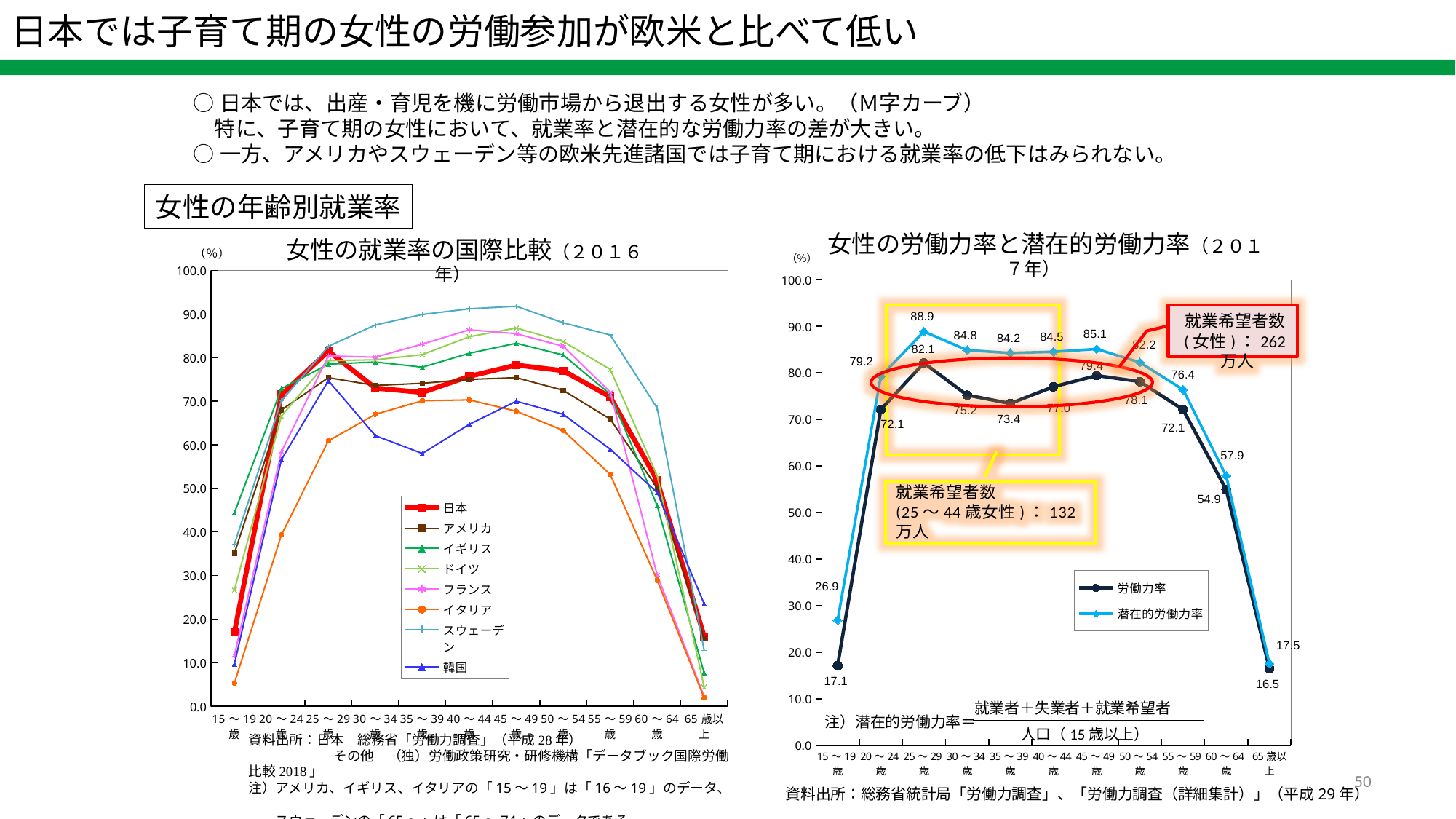
In the chart titled 女性の労働力率と潜在的労働力率（2017年）, how many series does the legend list? 2 In the chart titled 女性の就業率の国際比較（2016年）, is the value for 日本 at 35～39歳 greater or less than 80.0? less In the chart titled 女性の就業率の国際比較（2016年）, how many countries does the legend list? 8 In the chart titled 女性の就業率の国際比較（2016年）, is the value for イタリア at 15～19歳 greater or less than 10.0? less In the chart titled 女性の労働力率と潜在的労働力率（2017年）, which is larger for 60～64歳: 労働力率 or 潜在的労働力率? 潜在的労働力率 In the chart titled 女性の労働力率と潜在的労働力率（2017年）, what is the 労働力率 value for 35～39歳? 73.4 In the chart titled 女性の労働力率と潜在的労働力率（2017年）, which age group has the lowest 労働力率? 65歳以上 In the chart titled 女性の労働力率と潜在的労働力率（2017年）, what is the 潜在的労働力率 value for 25～29歳? 88.9 In the chart titled 女性の労働力率と潜在的労働力率（2017年）, what is the 労働力率 value for 25～29歳? 82.1 In the chart titled 女性の労働力率と潜在的労働力率（2017年）, which age group has the highest 潜在的労働力率? 25～29歳 What kind of chart is the chart titled 女性の就業率の国際比較（2016年）? line chart In the chart titled 女性の労働力率と潜在的労働力率（2017年）, what is the difference between the 潜在的労働力率 and the 労働力率 for 35～39歳? 10.8